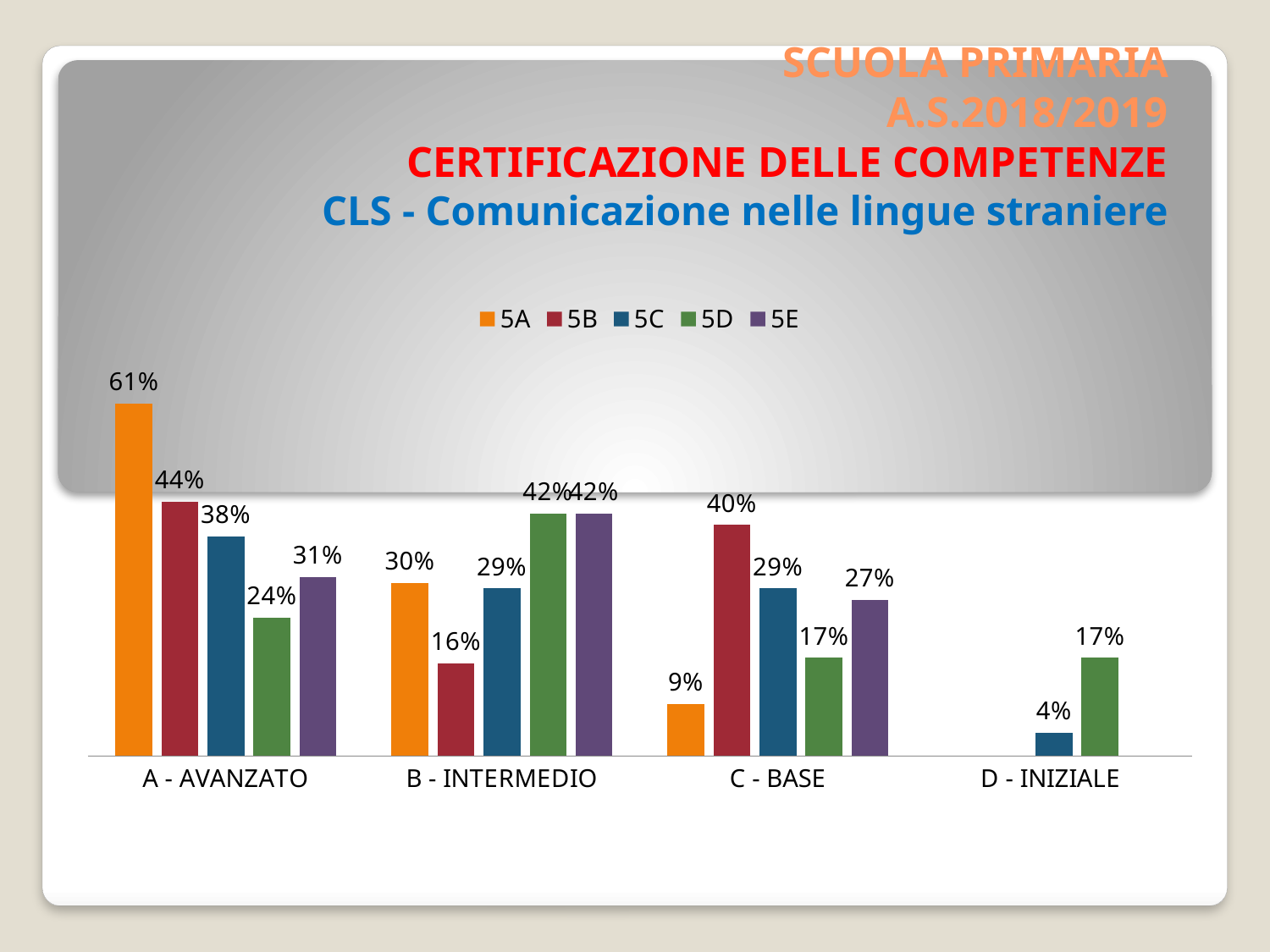
How many series does the legend list? 5 How many categories are shown on the x axis? 4 What is the value for 5E in the B - INTERMEDIO category? 42% Which series has the lowest value in the C - BASE category? 5A Which colour represents the 5D series in the legend? Green Which is larger in the B - INTERMEDIO category: the value for 5A or the value for 5B? 5A What is the value for 5D in the D - INIZIALE category? 17% What kind of chart is shown on the slide? Bar chart What is the difference between the 5A and 5B values in the A - AVANZATO category? 17% Which series has the highest value in the A - AVANZATO category? 5A What is the value for 5A in the A - AVANZATO category? 61% What is the value for 5B in the C - BASE category? 40%